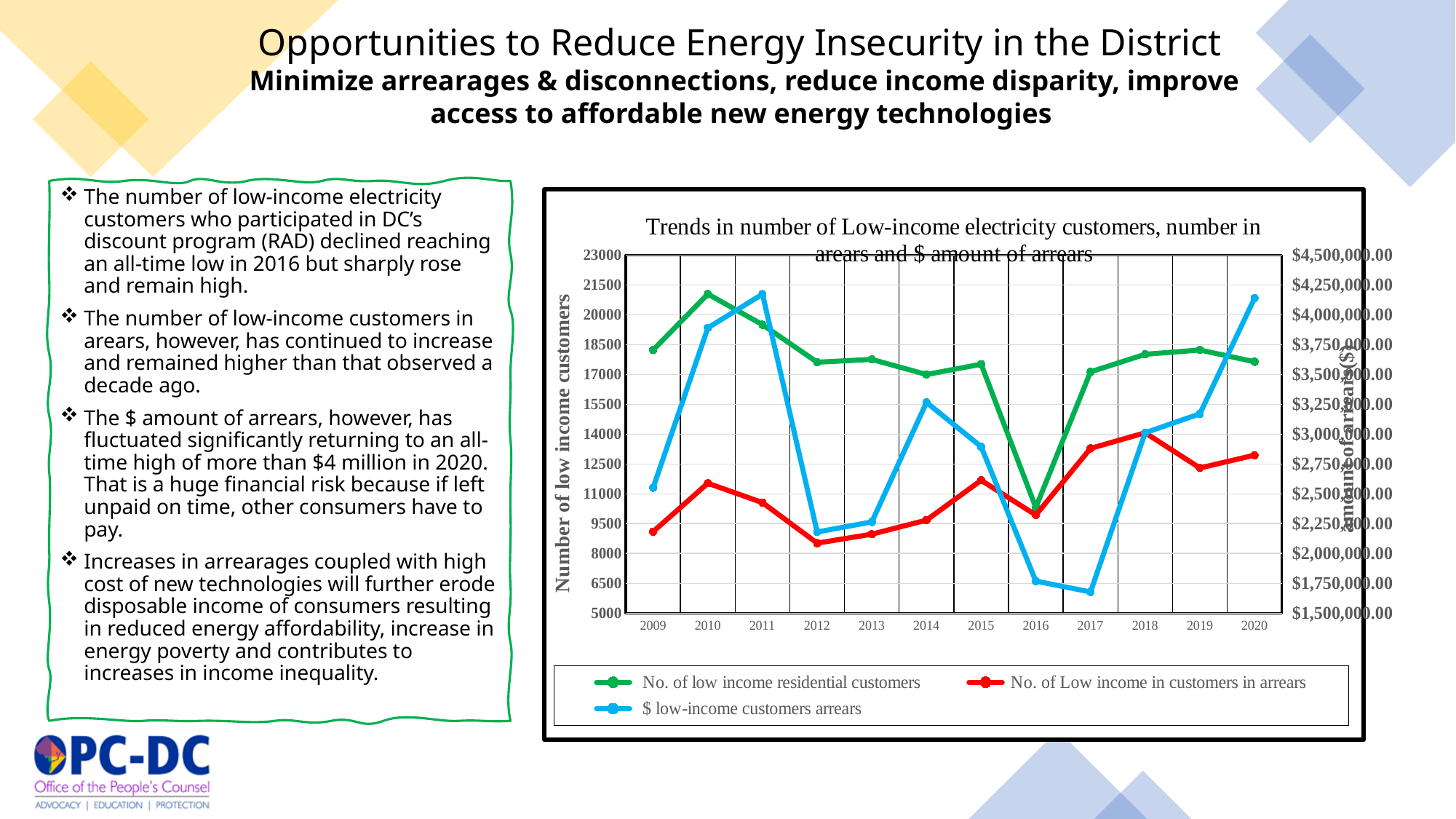
What is the label of the left vertical axis of the chart? Number of low income customers In which year is the number of low income residential customers lowest? 2016 Which is larger in 2009: the number of low income residential customers or the number of low income customers in arrears? No. of low income residential customers Does the number of low income customers in arrears rise or fall from 2016 to 2018? rise In which year is the $ low-income customers arrears value lowest? 2017 Is the number of low income residential customers in 2016 greater or less than 11000? less In which year is the number of low income residential customers highest? 2010 How many series does the chart legend list? 3 Is the $ low-income customers arrears value in 2017 greater or less than $2,000,000.00? less How many years are plotted along the x axis of the chart? 12 What kind of chart is shown on the slide? line chart In which year is the number of low income customers in arrears lowest? 2012